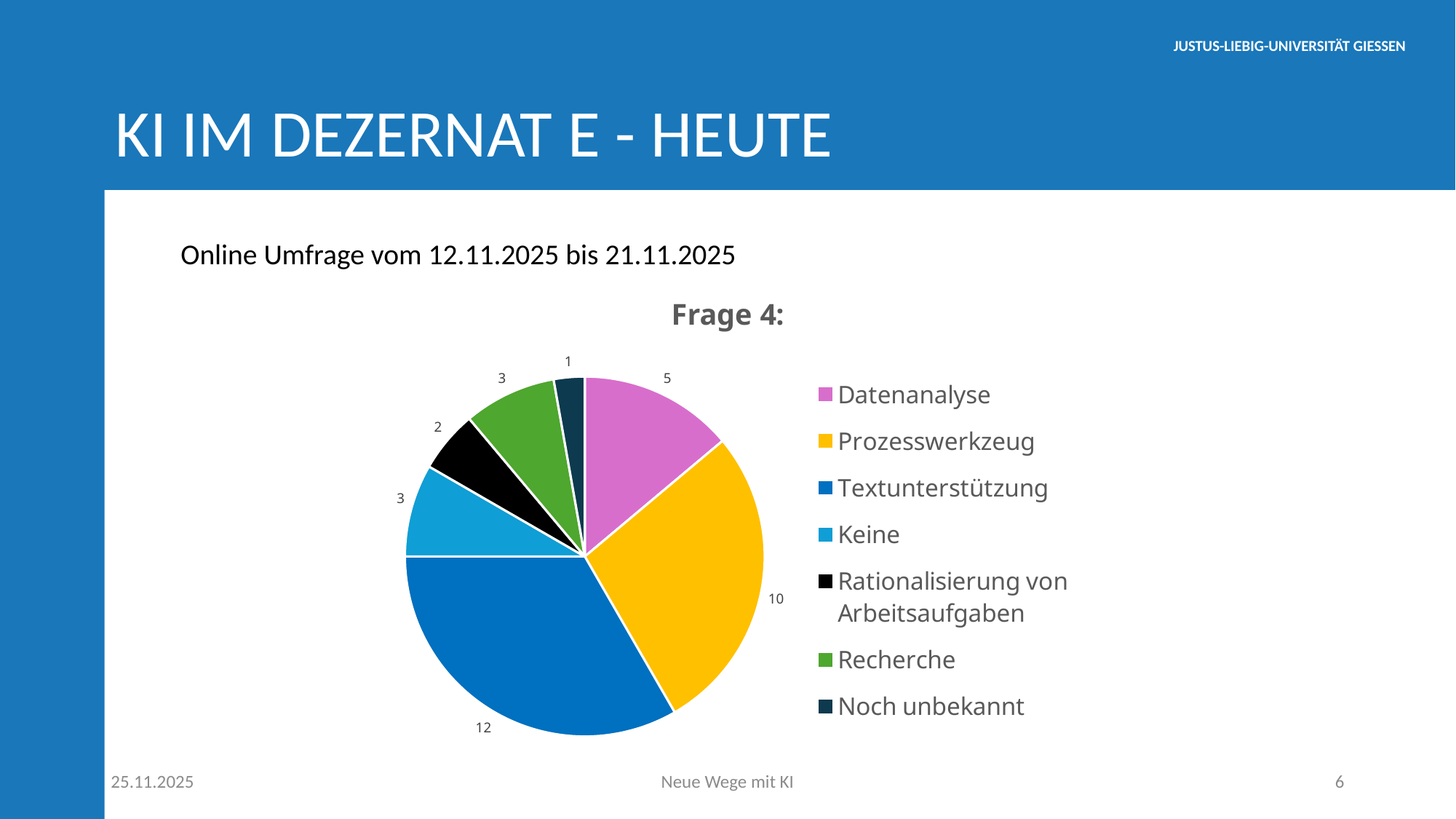
What is the title of the chart? Frage 4: What is the value for Rationalisierung von Arbeitsaufgaben? 2 Which category has the smallest slice of the pie? Noch unbekannt How many categories does the legend of the pie chart list? 7 What is the value for Prozesswerkzeug? 10 What is the total of all slices in the pie chart? 36 Which is larger, the value for Datenanalyse or the value for Keine? Datenanalyse What is the value for Datenanalyse? 5 What is the difference between the values for Textunterstützung and Prozesswerkzeug? 2 What is the value for Textunterstützung? 12 Which category has the largest slice of the pie? Textunterstützung What type of chart is shown on the slide? pie chart